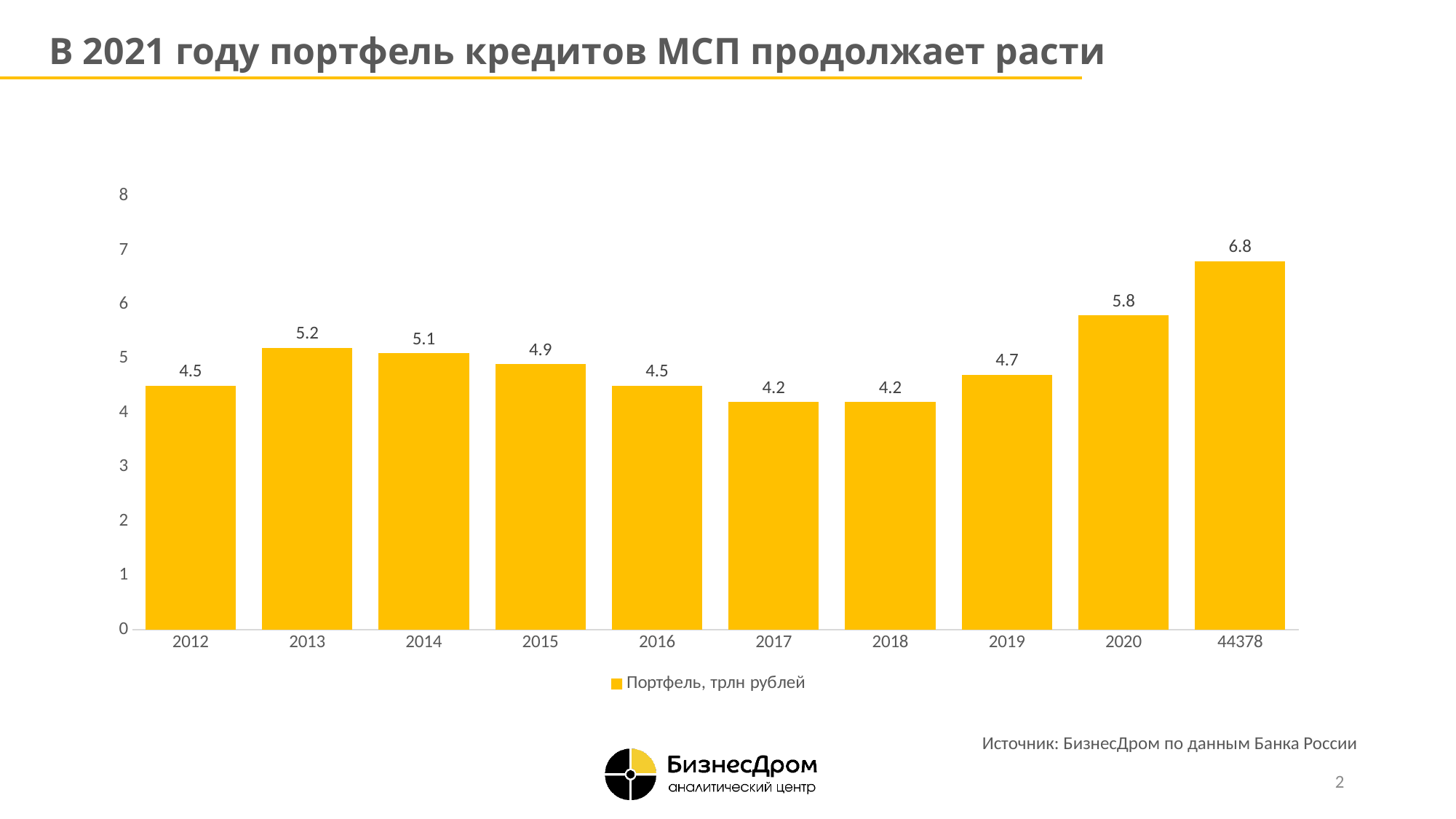
What is the value for 2020? 5.8 Which category has the highest value? 44378 What kind of chart is shown on the slide? bar chart What is the value for 2013? 5.2 Which year has the highest value among 2012 to 2020? 2020 How many categories are shown on the x axis? 10 What is the difference between the values for 2020 and 2019? 1.1 Which is larger, the value for 2014 or the value for 2016? 2014 What is the value for the category labelled 44378? 6.8 What is the difference between the values for 2013 and 2017? 1.0 What is the legend entry for the series? Портфель, трлн рублей What is the value for 2019? 4.7